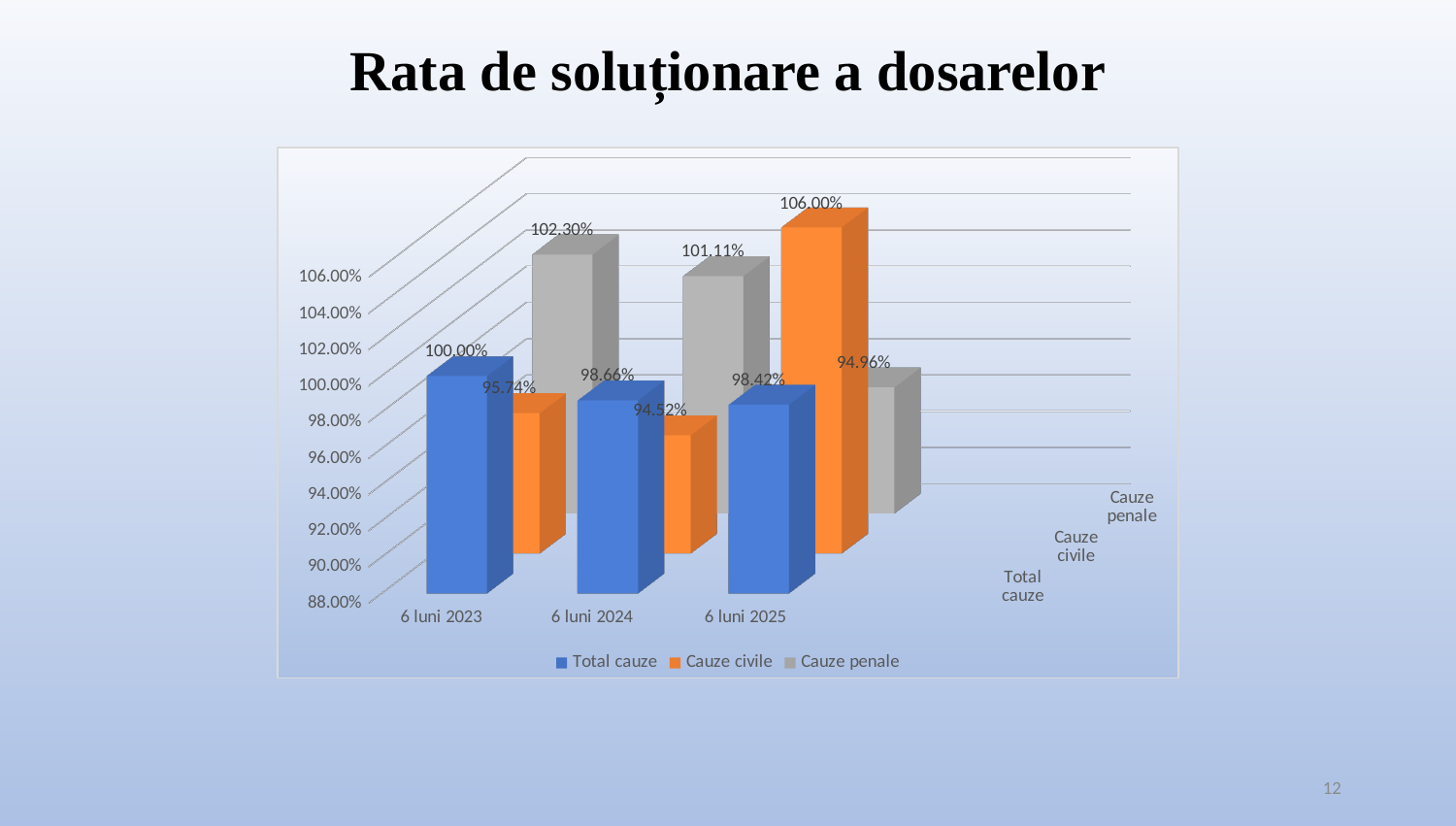
What is the value for Total cauze in 6 luni 2023? 100.00% How many periods are shown on the x axis? 3 How many series does the legend list? 3 What is the value for Cauze civile in 6 luni 2025? 106.00% What kind of chart is shown on the slide? Bar chart What is the value for Cauze civile in 6 luni 2024? 94.52% Does the value for Total cauze rise or fall from 6 luni 2023 to 6 luni 2025? Fall What is the value for Cauze penale in 6 luni 2024? 101.11% Which period has the highest value for Cauze penale? 6 luni 2023 What is the difference between Cauze penale and Cauze civile in 6 luni 2023? 6.56% Which is larger in 6 luni 2025: Total cauze or Cauze penale? Total cauze Which period has the lowest value for Cauze civile? 6 luni 2024